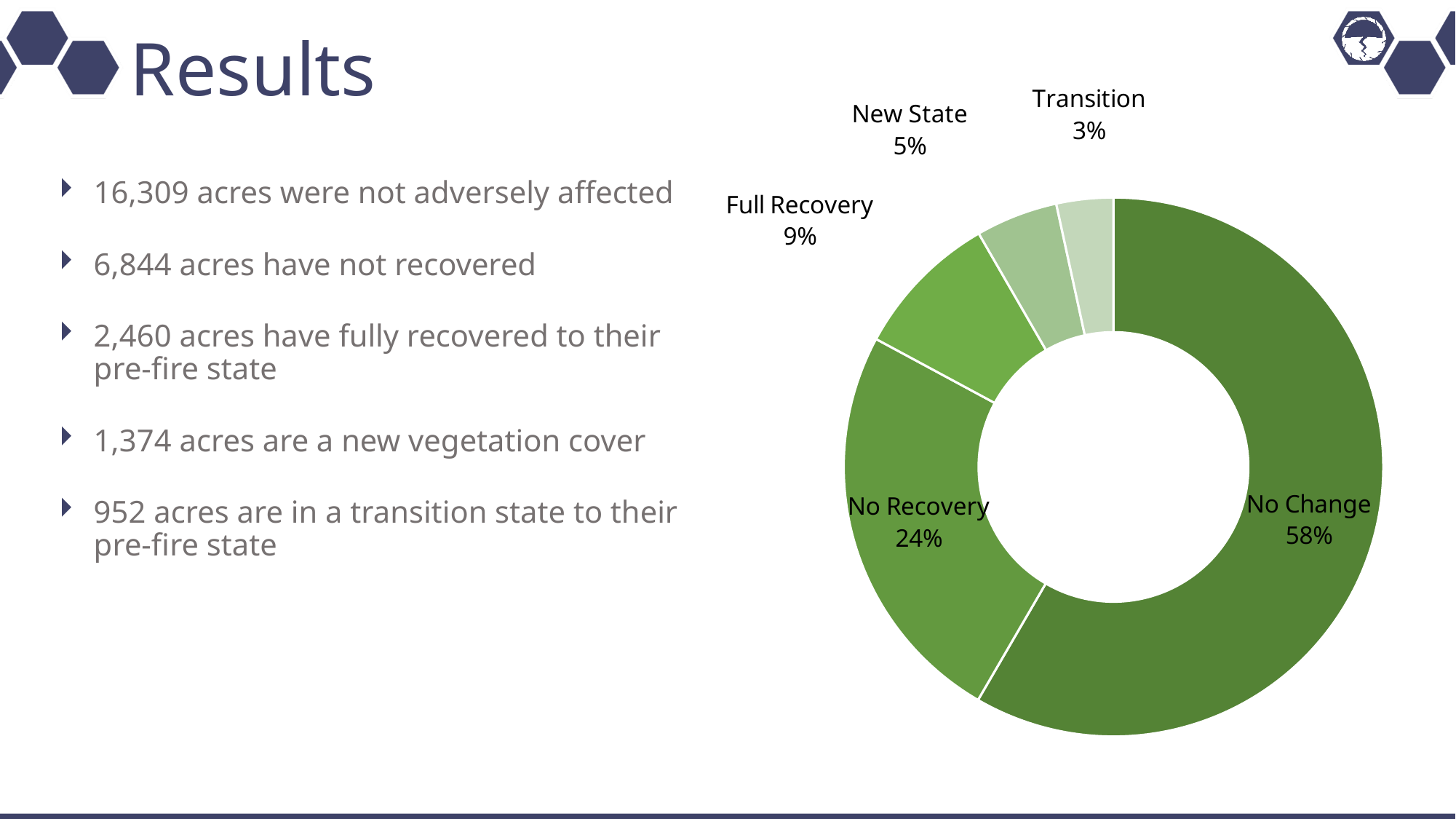
How many categories are shown in the chart? 5 What share of the pie does No Recovery represent? 24% What share of the pie does No Change represent? 58% Which category has the largest slice? No Change What kind of chart is shown on the slide? Pie chart (doughnut) What share of the pie does Full Recovery represent? 9% What is the difference in percentage points between No Change and No Recovery? 34 Which is larger, Full Recovery or New State? Full Recovery What is the title of the slide containing the chart? Results Which category has the smallest slice? Transition